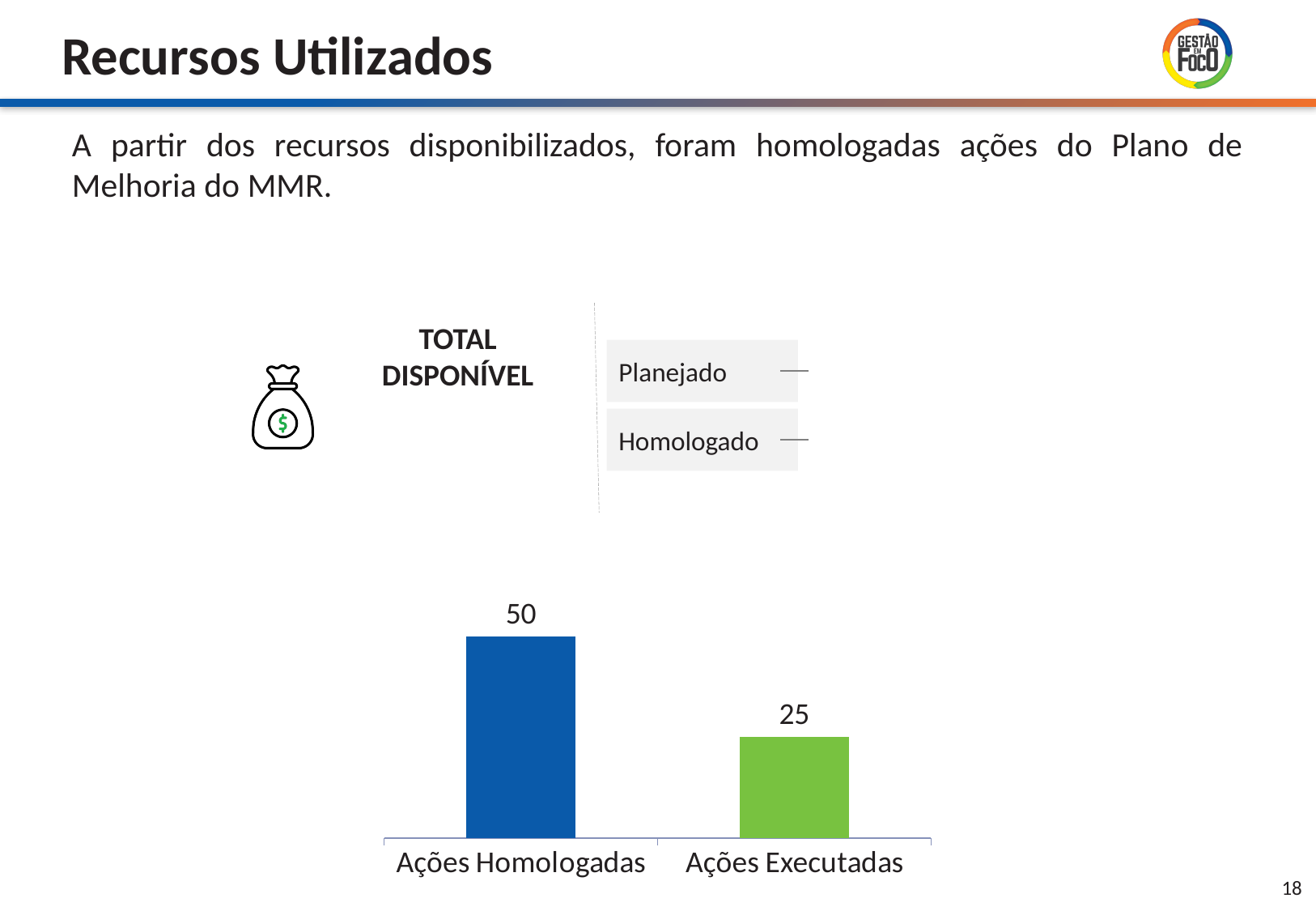
Which is larger, the value for Ações Homologadas or the value for Ações Executadas? Ações Homologadas What colour is the bar for Ações Executadas? Green What is the value for Ações Homologadas? 50 What colour is the bar for Ações Homologadas? Blue What is the difference between the values for Ações Homologadas and Ações Executadas? 25 Which category has the lowest value? Ações Executadas Which category has the highest value? Ações Homologadas Do the values rise or fall from left to right across the categories? Fall How many categories are shown in the chart? 2 What is the value for Ações Executadas? 25 What kind of chart is shown on the slide? Bar chart